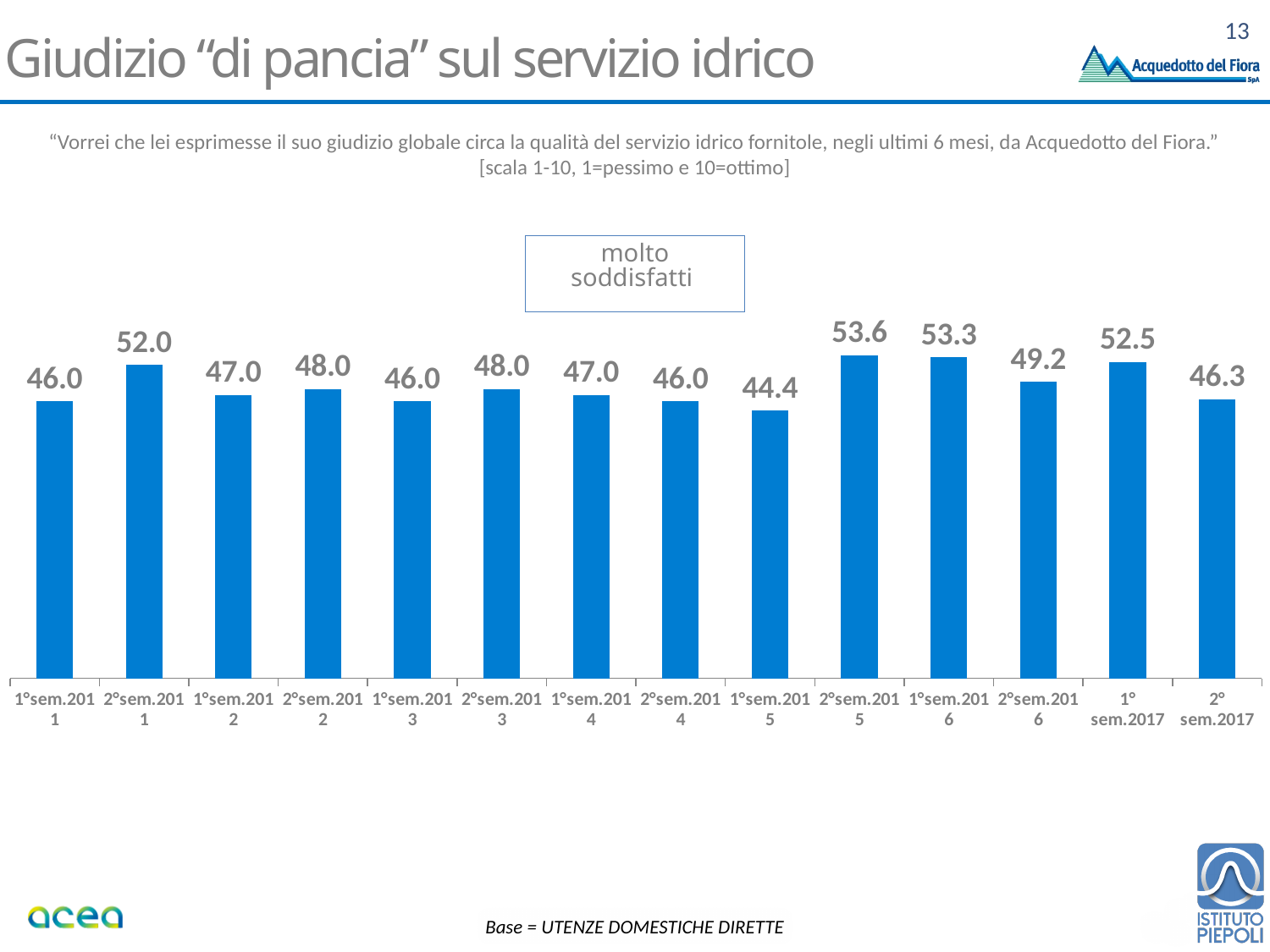
What kind of chart is shown on the slide? Bar chart What is the difference between the values for 1°sem.2017 and 2°sem.2017? 6.2 What is the value for 2°sem.2011? 52.0 What is the value for 2°sem.2017? 46.3 What is the value for 2°sem.2015? 53.6 What label appears in the box above the bars? molto soddisfatti What is the difference between the values for 2°sem.2015 and 1°sem.2015? 9.2 Which is larger, the value for 2°sem.2016 or the value for 1°sem.2014? 2°sem.2016 How many periods (bars) are shown in the chart? 14 Which period has the highest value? 2°sem.2015 What is the value for 1°sem.2015? 44.4 Which period has the lowest value? 1°sem.2015